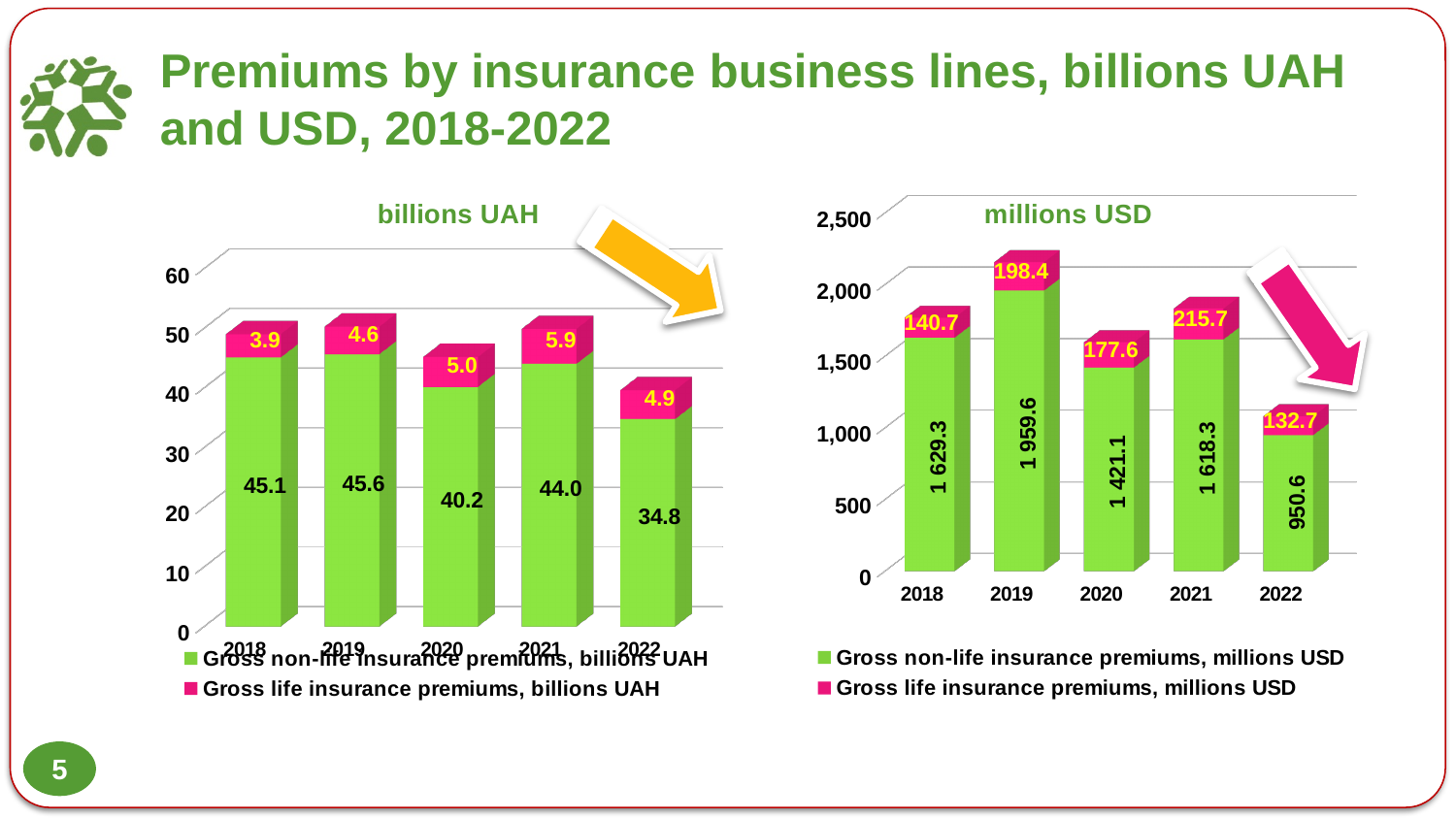
In the 'millions USD' chart, is the value of gross non-life insurance premiums in 2022 greater or less than 1 629.3 in 2018? less In the 'millions USD' chart, which year has the highest gross life insurance premiums? 2021 In the 'billions UAH' chart, what is the difference between gross non-life insurance premiums in 2019 and 2022? 10.8 How many series does the legend of the 'billions UAH' chart list? 2 How many years are shown on the x axis of the 'millions USD' chart? 5 In the 'millions USD' chart, what is the value of gross non-life insurance premiums in 2019? 1 959.6 In the 'billions UAH' chart, what is the value of gross non-life insurance premiums in 2020? 40.2 In the 'billions UAH' chart, what is the value of gross life insurance premiums in 2021? 5.9 In the 'millions USD' chart, what is the value of gross life insurance premiums in 2022? 132.7 In the 'billions UAH' chart, which year has the lowest gross non-life insurance premiums? 2022 In the 'billions UAH' chart, what is the total of the stacked bar for 2019? 50.2 What kind of chart is the 'millions USD' chart? Stacked bar chart